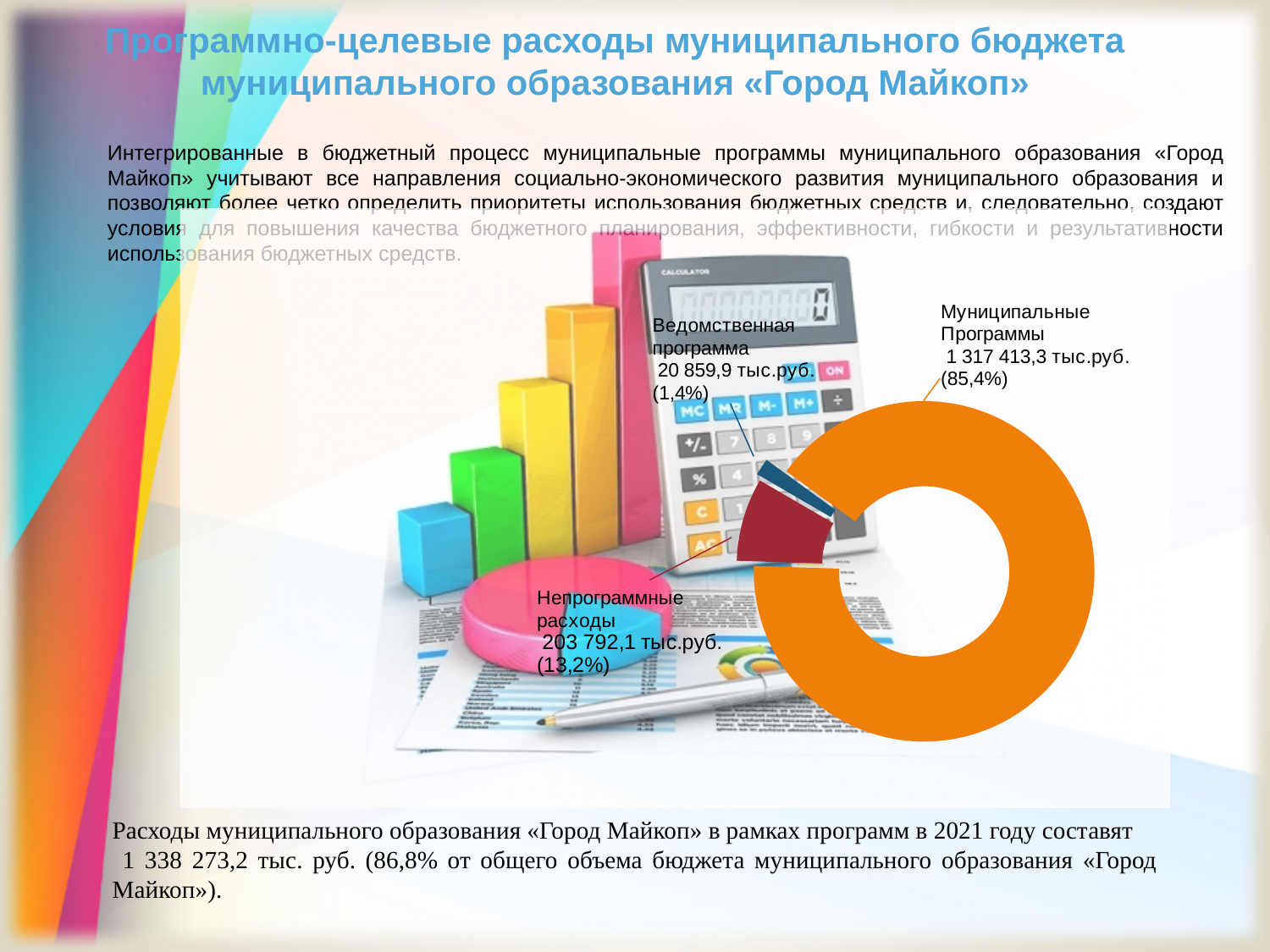
Which category has the smallest slice of the doughnut chart? Ведомственная программа What is the value for Муниципальные Программы? 1 317 413,3 тыс.руб. What kind of chart is shown on the slide? Doughnut (ring) chart What share of the doughnut chart does Ведомственная программа take? 1,4% Which is larger: Непрограммные расходы or Ведомственная программа? Непрограммные расходы What is the difference between Непрограммные расходы and Ведомственная программа? 182 932,2 тыс.руб. How many slices does the doughnut chart have? 3 What is the value for Ведомственная программа? 20 859,9 тыс.руб. Which category has the largest slice of the doughnut chart? Муниципальные Программы What share of the doughnut chart does Непрограммные расходы take? 13,2% What share of the doughnut chart does Муниципальные Программы take? 85,4% What is the value for Непрограммные расходы? 203 792,1 тыс.руб.